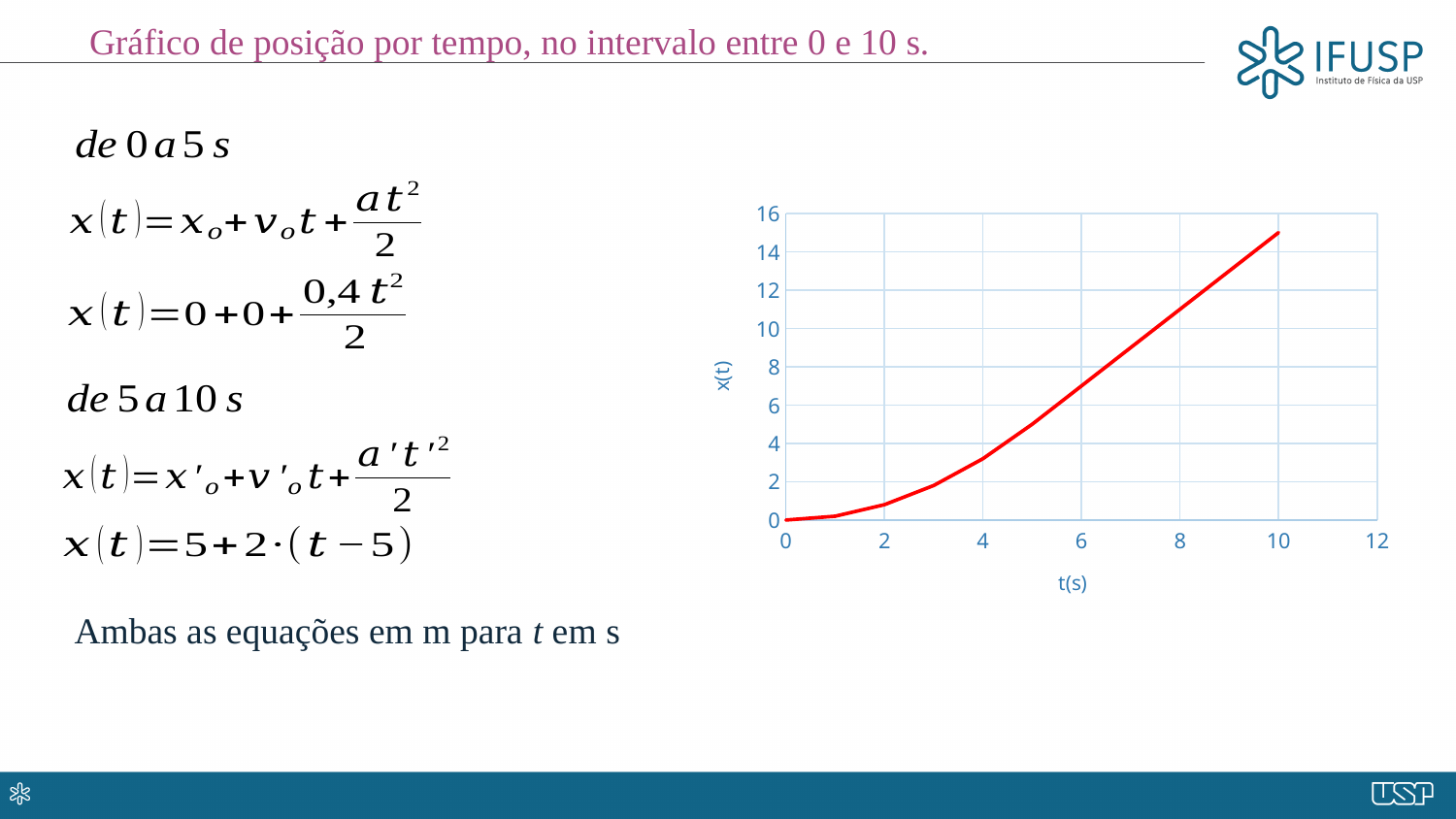
What is the label of the horizontal axis of the chart? t(s) Does the plotted value x(t) rise or fall as t increases from 0 to 10 s? rise What is the value of x(t) at t = 0 s? 0 Is the value of x(t) at t = 2 s greater or less than 2? less Is the value of x(t) at t = 10 s greater or less than 14? greater Is the value of x(t) at t = 8 s greater or less than 12? less What kind of chart is shown on the slide? line chart What colour is the plotted line in the chart? red At which value of t does the plotted curve reach its highest x(t)? 10